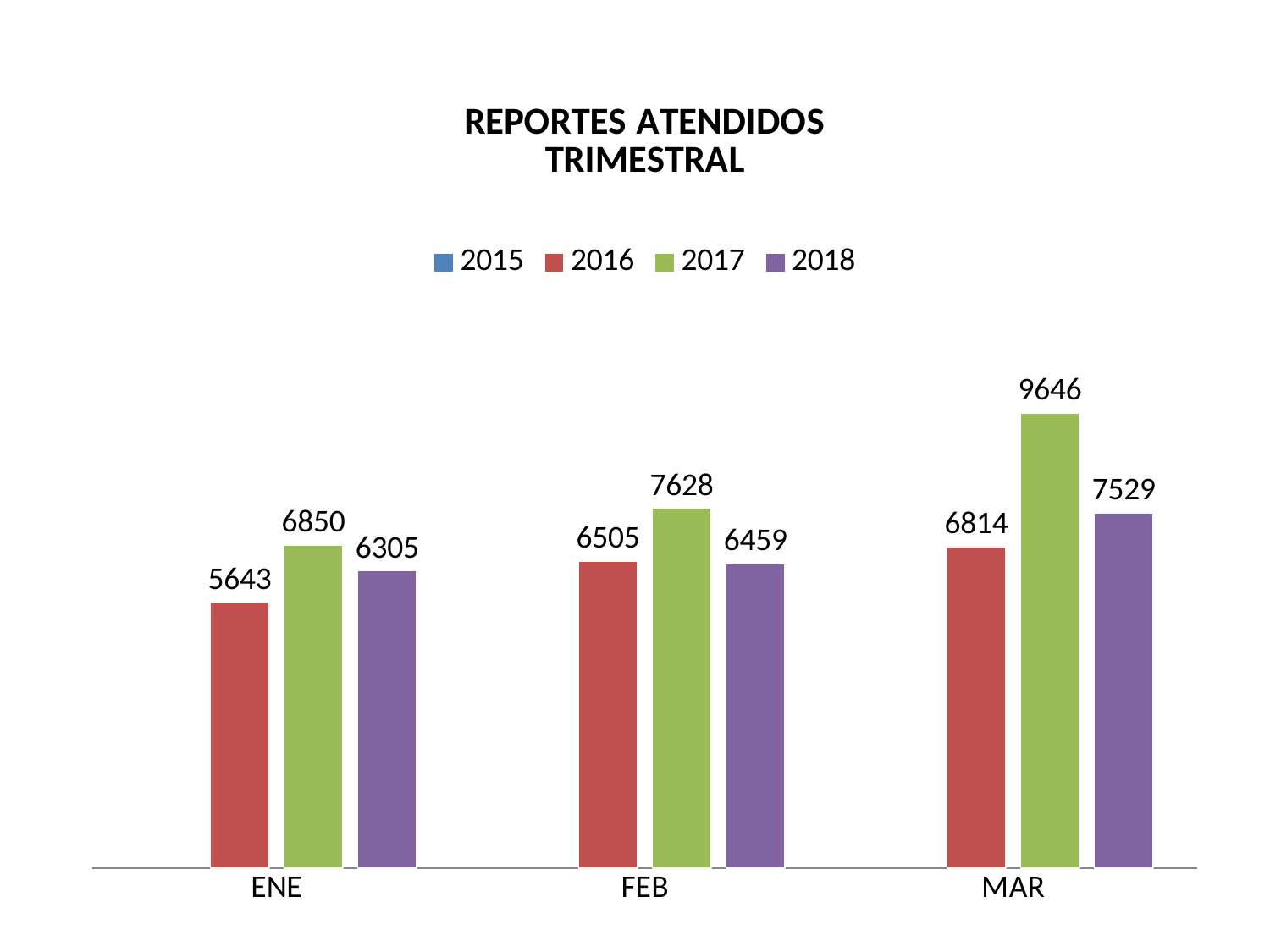
How many month categories are shown on the x axis? 3 What kind of chart is shown on the slide? Bar chart How many series does the legend list? 4 Which month has the highest value for the 2017 series? MAR What is the difference between the 2017 and 2016 values in MAR? 2832 Do the values for the 2017 series rise or fall from ENE to MAR? Rise Which month has the lowest value for the 2016 series? ENE What is the value for 2016 in ENE? 5643 What is the value for 2018 in FEB? 6459 What is the value for 2017 in MAR? 9646 Which is larger in FEB, the 2016 value or the 2018 value? 2016 What is the difference between the 2017 and 2018 values in ENE? 545